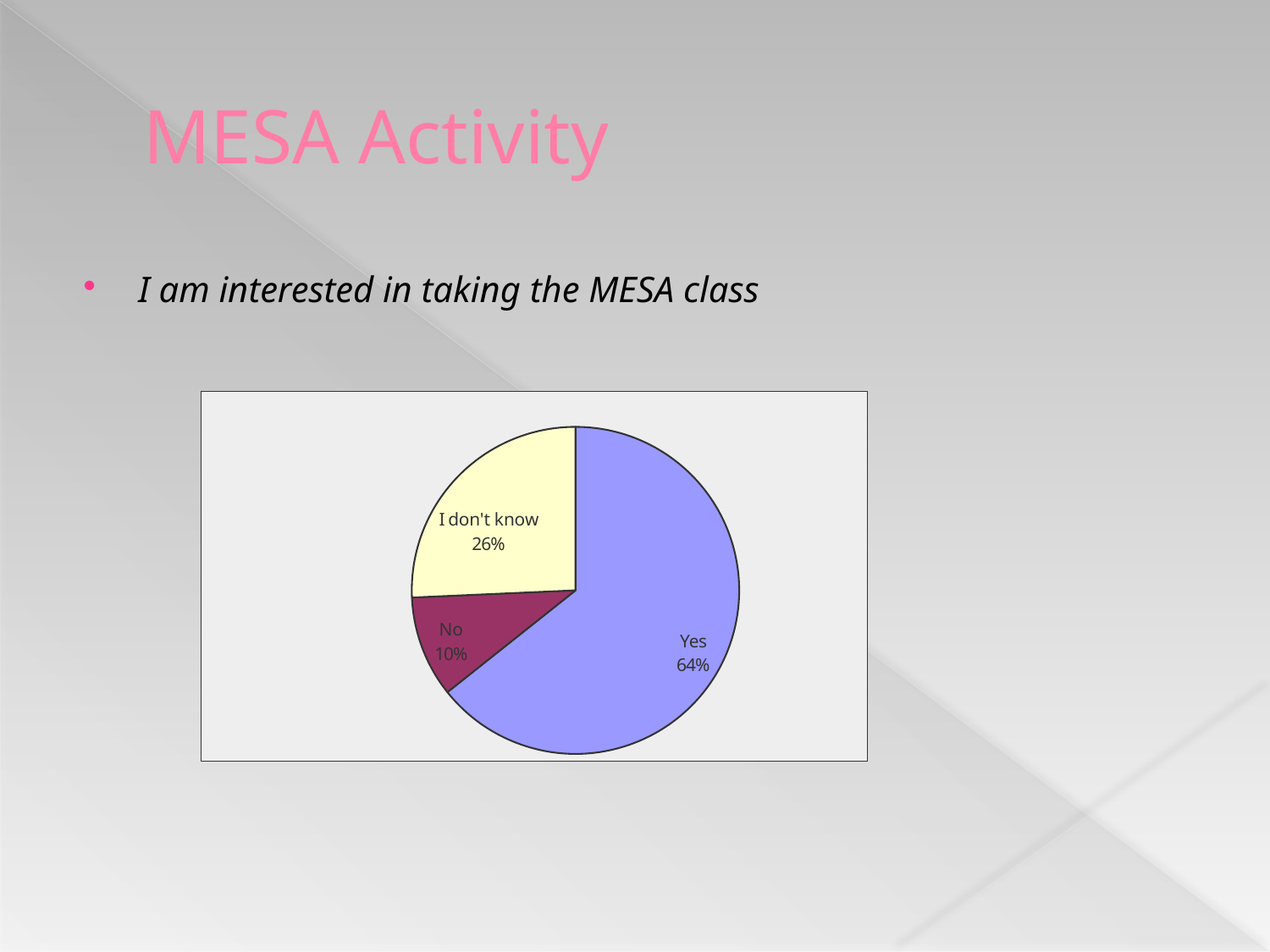
Which is larger, the "No" slice or the "I don't know" slice? I don't know What is the difference in percentage points between the "Yes" and "I don't know" slices? 38 What share of the pie does the "Yes" slice represent? 64% What percentage of respondents answered "I don't know"? 26% How many slices does the pie chart have? 3 What kind of chart is shown on the slide? Pie chart What colour is the "No" slice of the pie chart? Dark magenta What percentage of respondents answered "Yes" to being interested in taking the MESA class? 64% What is the difference in percentage points between the "I don't know" and "No" slices? 16 Which response has the smallest share of the pie? No What percentage of respondents answered "No"? 10% Which response has the largest share of the pie? Yes